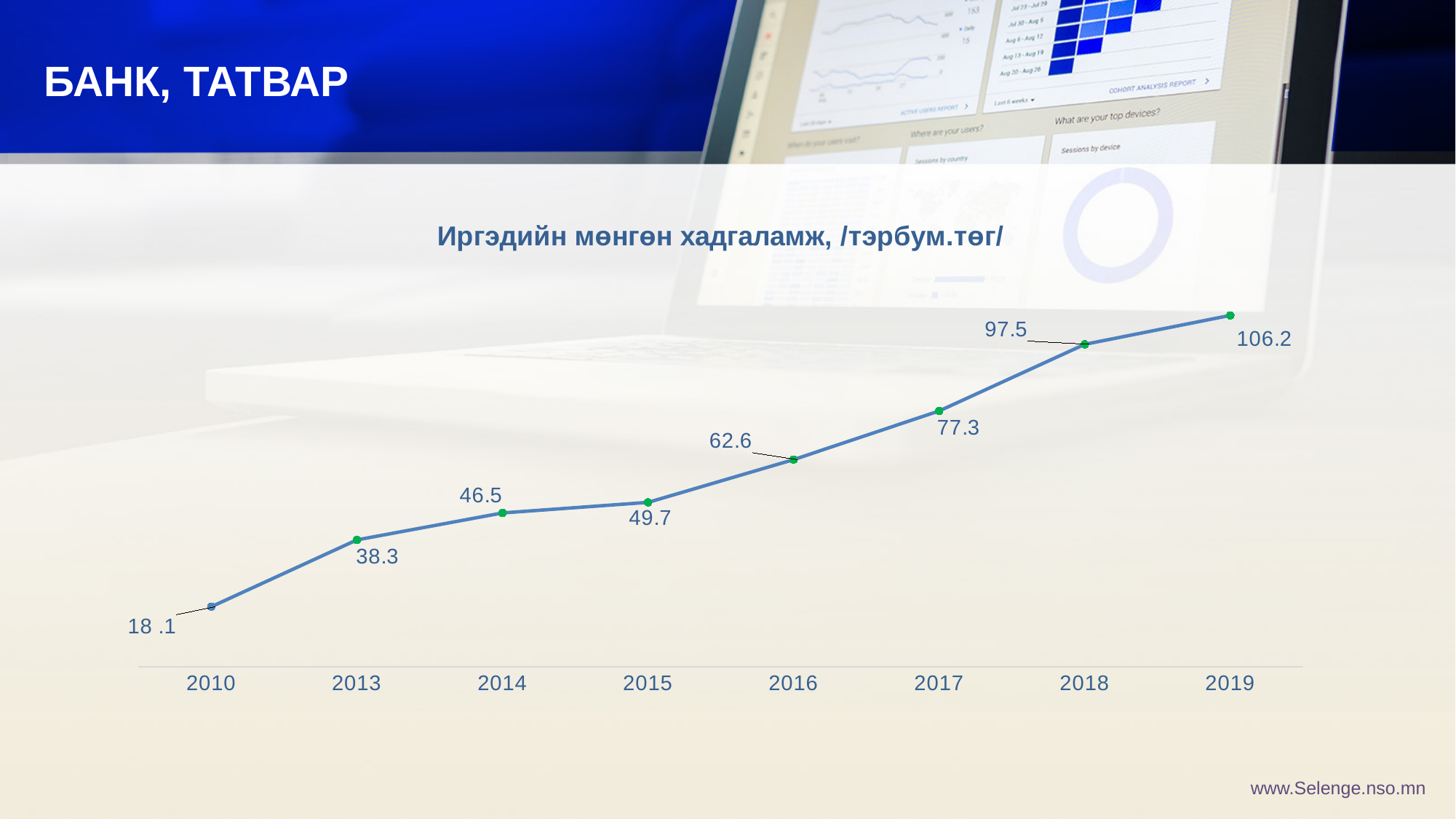
What is the title of the chart? Иргэдийн мөнгөн хадгаламж, /тэрбум.төг/ What is the value for 2018? 97.5 What is the value for 2019? 106.2 Which year has the highest value? 2019 How many years are plotted on the x axis? 8 What is the difference between the values for 2018 and 2017? 20.2 What type of chart is shown on the slide? line chart Which year has the lowest value? 2010 What is the difference between the values for 2015 and 2014? 3.2 What is the value for 2013? 38.3 Which is larger, the value for 2015 or the value for 2016? 2016 What is the value for 2016? 62.6